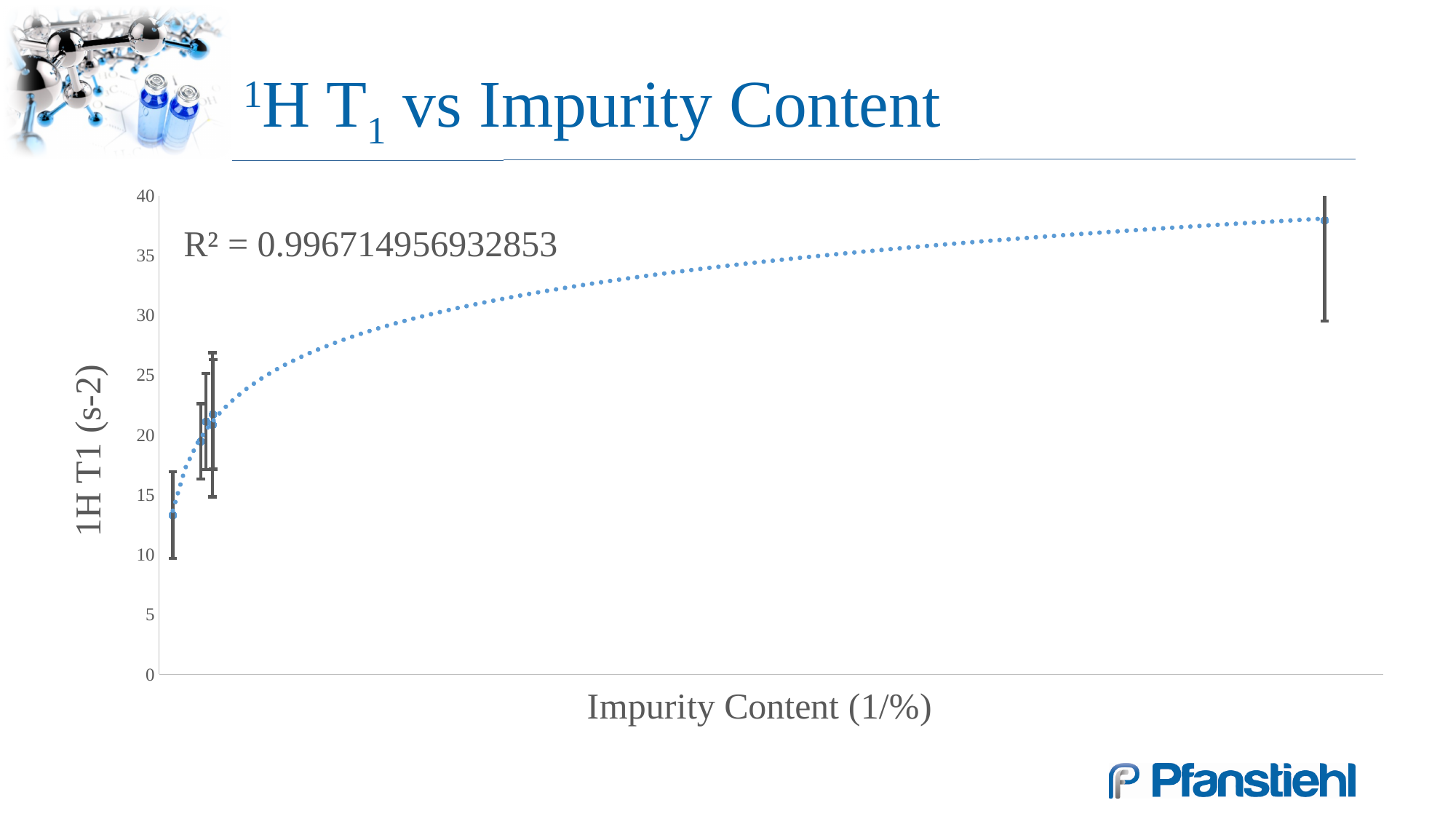
Is the 1H T1 value of the rightmost data point greater or less than 35? greater What is the title of the x axis of the chart? Impurity Content (1/%) Is the 1H T1 value of the leftmost data point greater or less than 15? less Which data point has the highest 1H T1 value, the leftmost point or the rightmost point? the rightmost point What kind of chart is shown on the slide? scatter chart Are the 1H T1 values of the cluster of points near the left of the chart greater or less than 25? less What is the highest value shown on the y axis of the chart? 40 What R² value is printed on the chart? R² = 0.996714956932853 Do the 1H T1 values rise or fall as impurity content increases along the x axis? rise